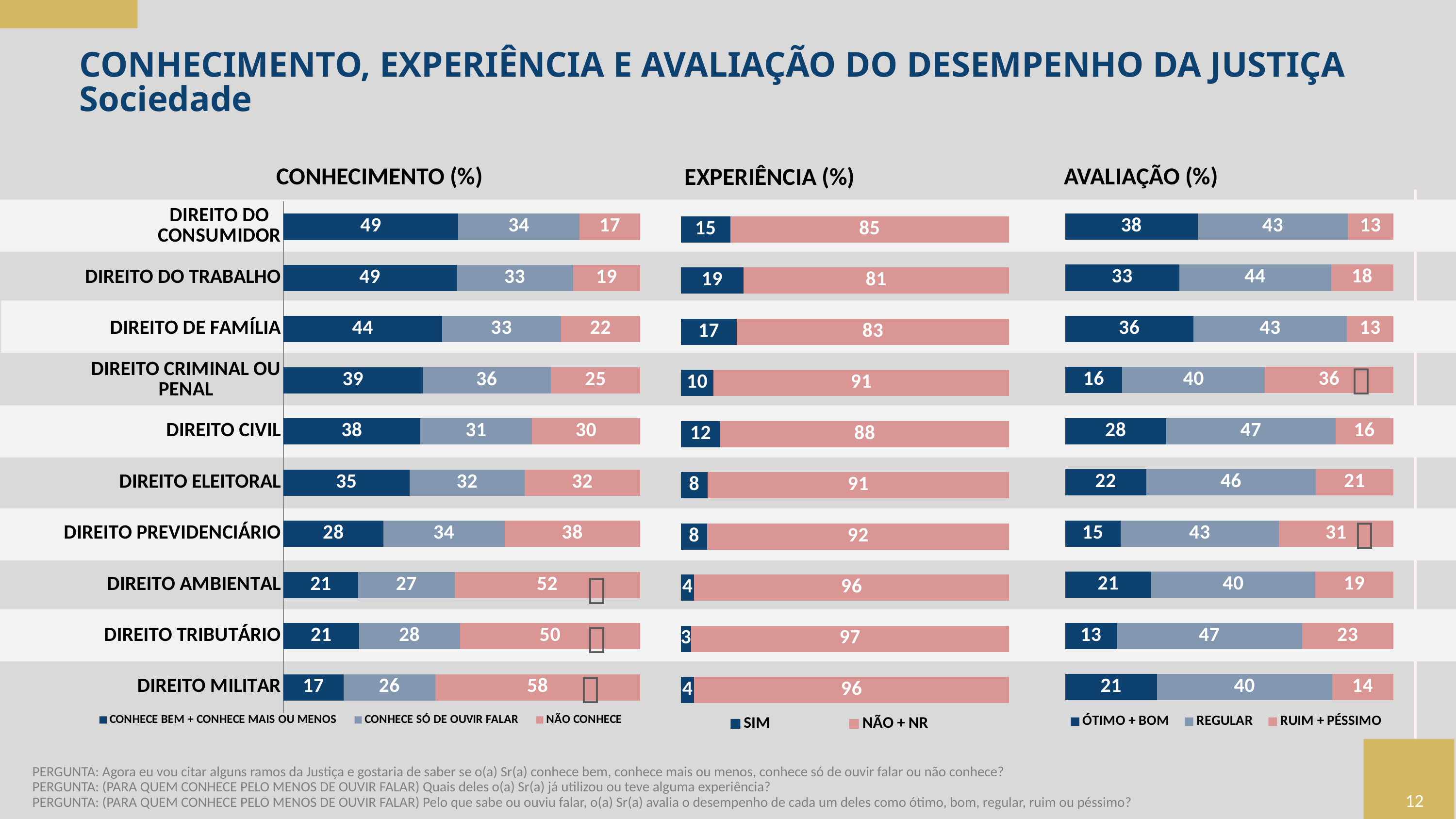
What kind of chart is the CONHECIMENTO (%) chart? Stacked bar chart In the EXPERIÊNCIA (%) chart, what is the SIM value for DIREITO DO TRABALHO? 19 In the CONHECIMENTO (%) chart, what is the NÃO CONHECE value for DIREITO MILITAR? 58 In the CONHECIMENTO (%) chart, what is the total of the three segments for DIREITO DO CONSUMIDOR? 100 In the AVALIAÇÃO (%) chart, which has the larger ÓTIMO + BOM value: DIREITO DO CONSUMIDOR or DIREITO DE FAMÍLIA? DIREITO DO CONSUMIDOR How many series does the legend of the AVALIAÇÃO (%) chart list? 3 In the EXPERIÊNCIA (%) chart, which category has the highest SIM value? DIREITO DO TRABALHO In the AVALIAÇÃO (%) chart, which category has the highest RUIM + PÉSSIMO value? DIREITO CRIMINAL OU PENAL How many categories are shown in the CONHECIMENTO (%) chart? 10 In the AVALIAÇÃO (%) chart, what is the REGULAR value for DIREITO CIVIL? 47 In the CONHECIMENTO (%) chart, what is the difference between the NÃO CONHECE value for DIREITO MILITAR and for DIREITO DO CONSUMIDOR? 41 In the EXPERIÊNCIA (%) chart, which category has the lowest SIM value? DIREITO TRIBUTÁRIO